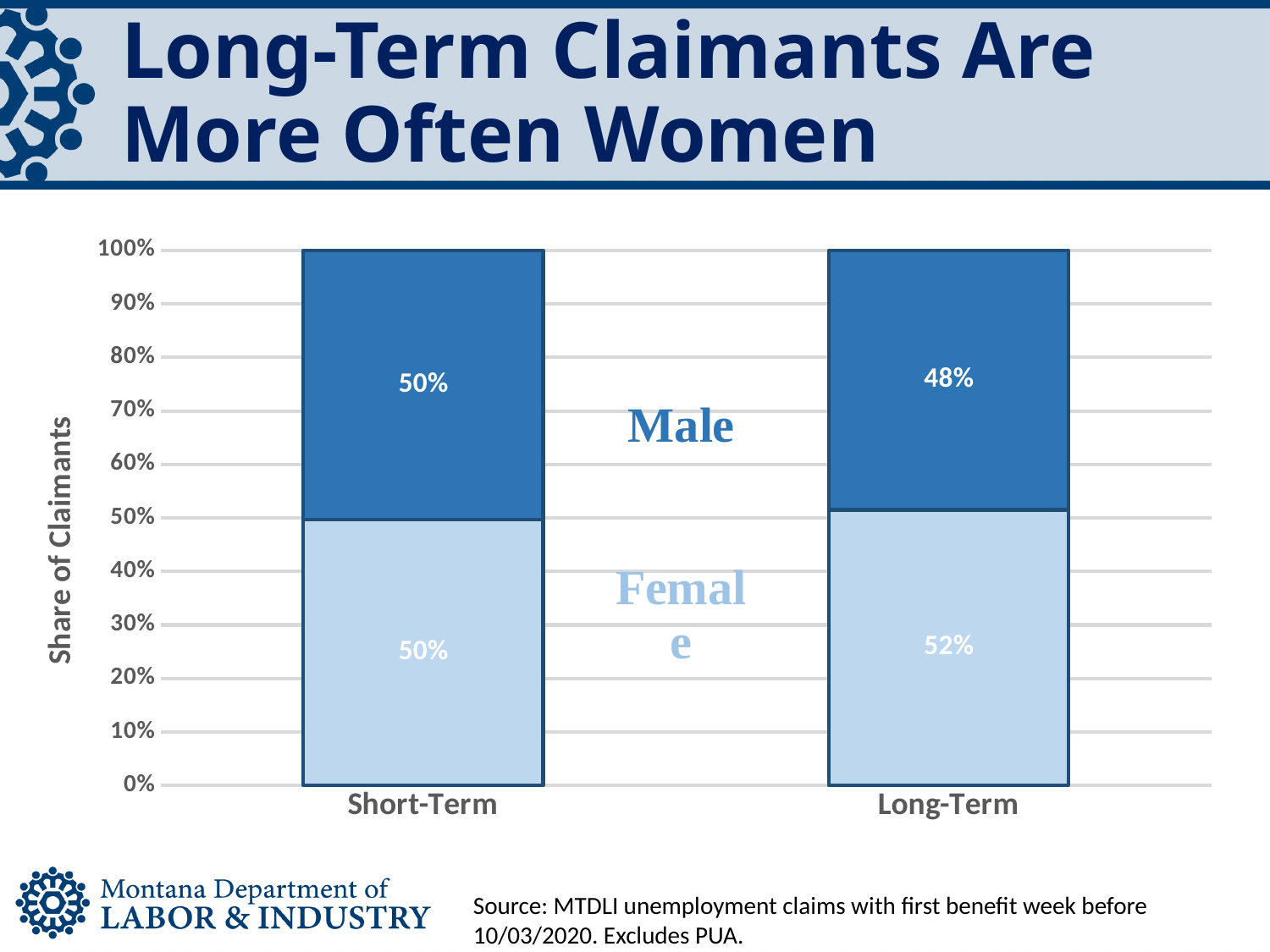
What is the label on the vertical axis of the chart? Share of Claimants What is the Female share of Short-Term claimants? 50% Which category has the higher Female share, Short-Term or Long-Term? Long-Term What is the difference between the Female and Male shares for Long-Term claimants? 4% What is the Male share of Long-Term claimants? 48% Which category has the lower Male share? Long-Term What is the Female share of Long-Term claimants? 52% What kind of chart is shown on the slide? Stacked bar chart What is the total of the stacked bar for Long-Term claimants? 100% How many categories are shown on the x axis? 2 How many series are shown in the chart? 2 What is the Male share of Short-Term claimants? 50%